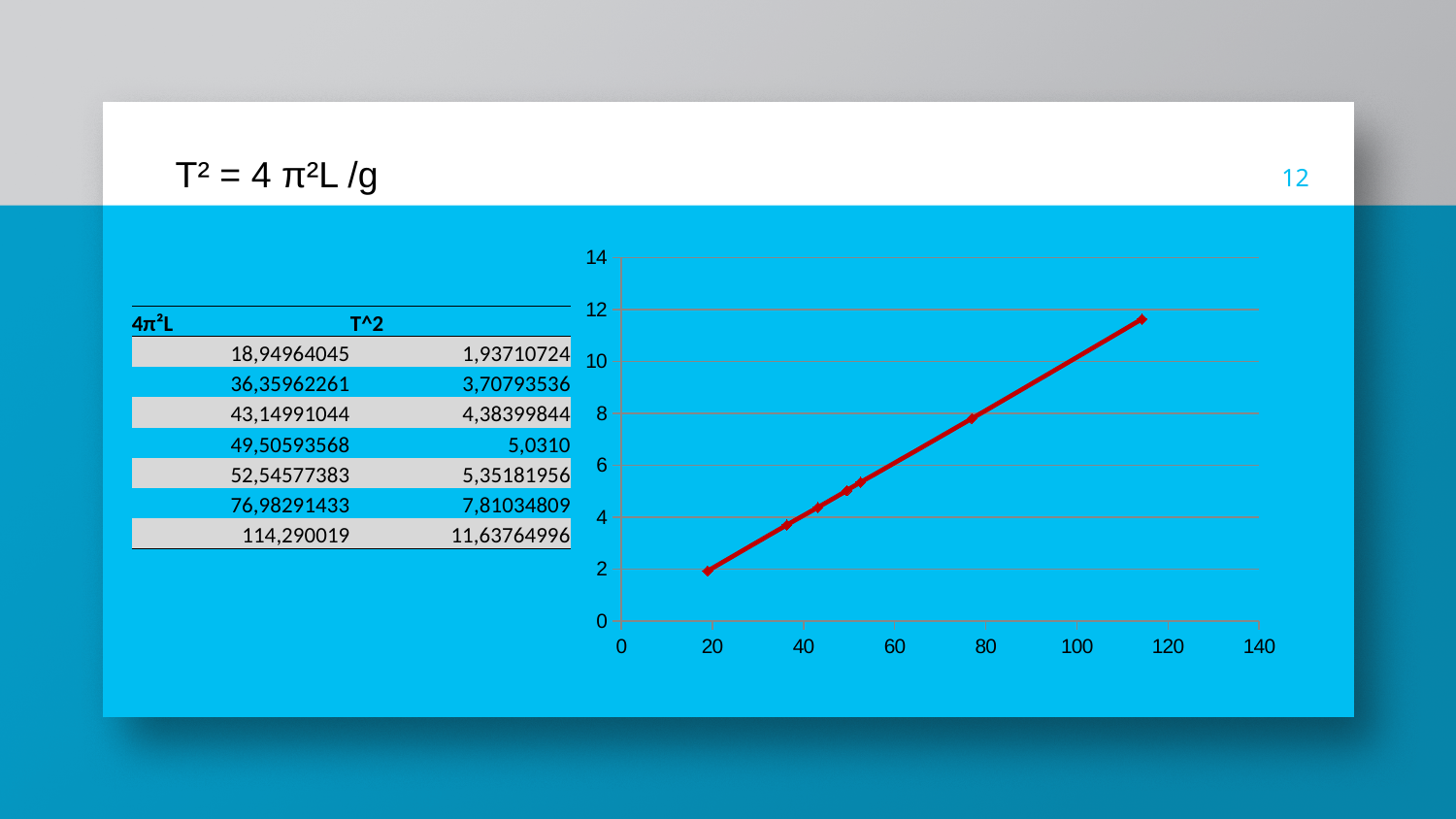
What is the maximum value shown on the chart's vertical axis? 14 What is the difference between the highest and lowest T^2 values in the table? 9,70054272 Which 4π²L value in the table has the lowest T^2? 18,94964045 What kind of chart is shown on the slide? line chart Which 4π²L value in the table has the highest T^2? 114,290019 Is the value of the rightmost plotted point greater or less than 10? greater According to the table, what is the T^2 value for 4π²L = 18,94964045? 1,93710724 Do the plotted values rise or fall as the x-axis value increases? rise According to the table, what is the T^2 value for 4π²L = 114,290019? 11,63764996 According to the table, what is the T^2 value for 4π²L = 49,50593568? 5,0310 How many data points are plotted on the chart? 7 Is the value of the leftmost plotted point greater or less than 4? less